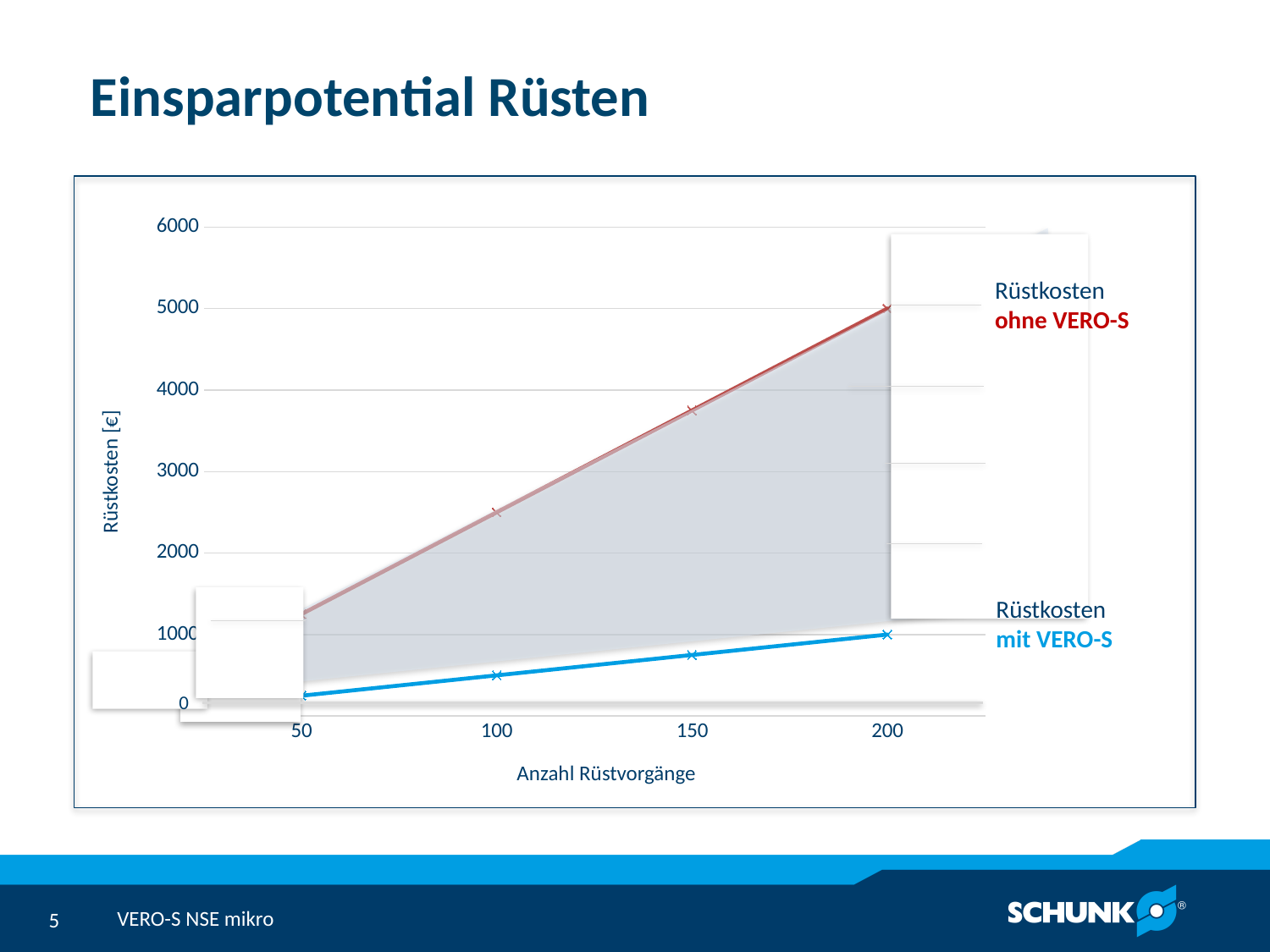
Is the value for Rüstkosten ohne VERO-S at 100 Rüstvorgänge greater or less than 2000? greater What is the difference between Rüstkosten ohne VERO-S and Rüstkosten mit VERO-S at 200 Rüstvorgänge? 4000 At 200 Rüstvorgänge, which series has the higher value, ohne VERO-S or mit VERO-S? ohne VERO-S What is the label of the x axis? Anzahl Rüstvorgänge Is the value for Rüstkosten mit VERO-S at 150 Rüstvorgänge greater or less than 1000? less How many data points does each series have? 4 What is the value of Rüstkosten ohne VERO-S at 200 Rüstvorgänge? 5000 Is the value for Rüstkosten ohne VERO-S at 150 Rüstvorgänge greater or less than 3000? greater What type of chart is shown on the slide? Line chart Do the Rüstkosten ohne VERO-S rise or fall as the Anzahl Rüstvorgänge increases? Rise How many series does the chart show? 2 What is the value of Rüstkosten mit VERO-S at 200 Rüstvorgänge? 1000